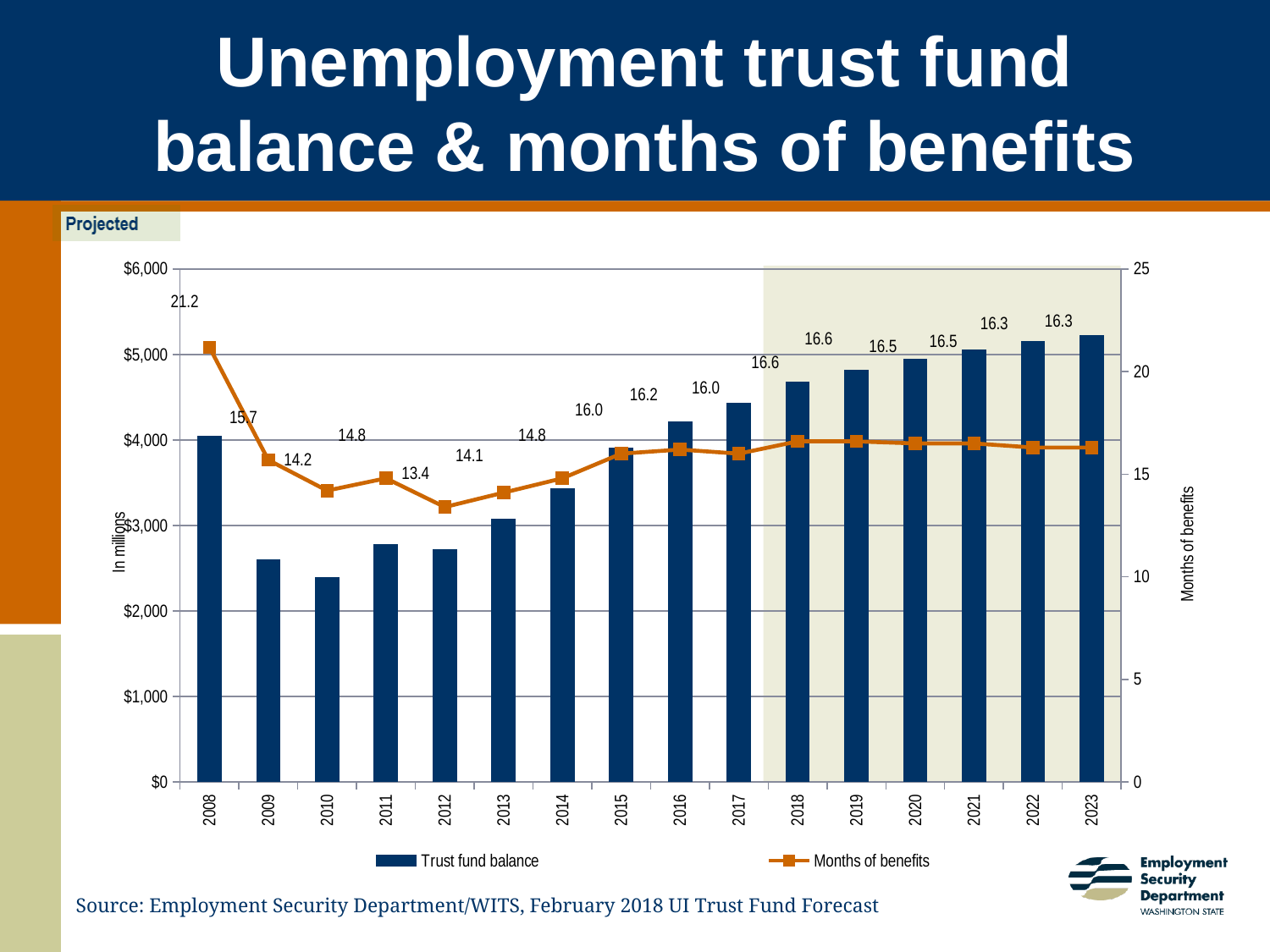
What is the difference between the months of benefits in 2008 and in 2012? 7.8 Is the trust fund balance for 2010 greater or less than $3,000? less What is the months of benefits value for 2008? 21.2 How many years are shown on the x axis? 16 What is the months of benefits value for 2012? 13.4 What is the months of benefits value for 2023? 16.3 How many series does the legend list? 2 Which year has the highest months of benefits? 2008 Which year has the larger months of benefits value, 2015 or 2016? 2016 Is the trust fund balance for 2023 greater or less than $5,000? greater Which year has the lowest months of benefits? 2012 Which year has the lowest trust fund balance? 2010